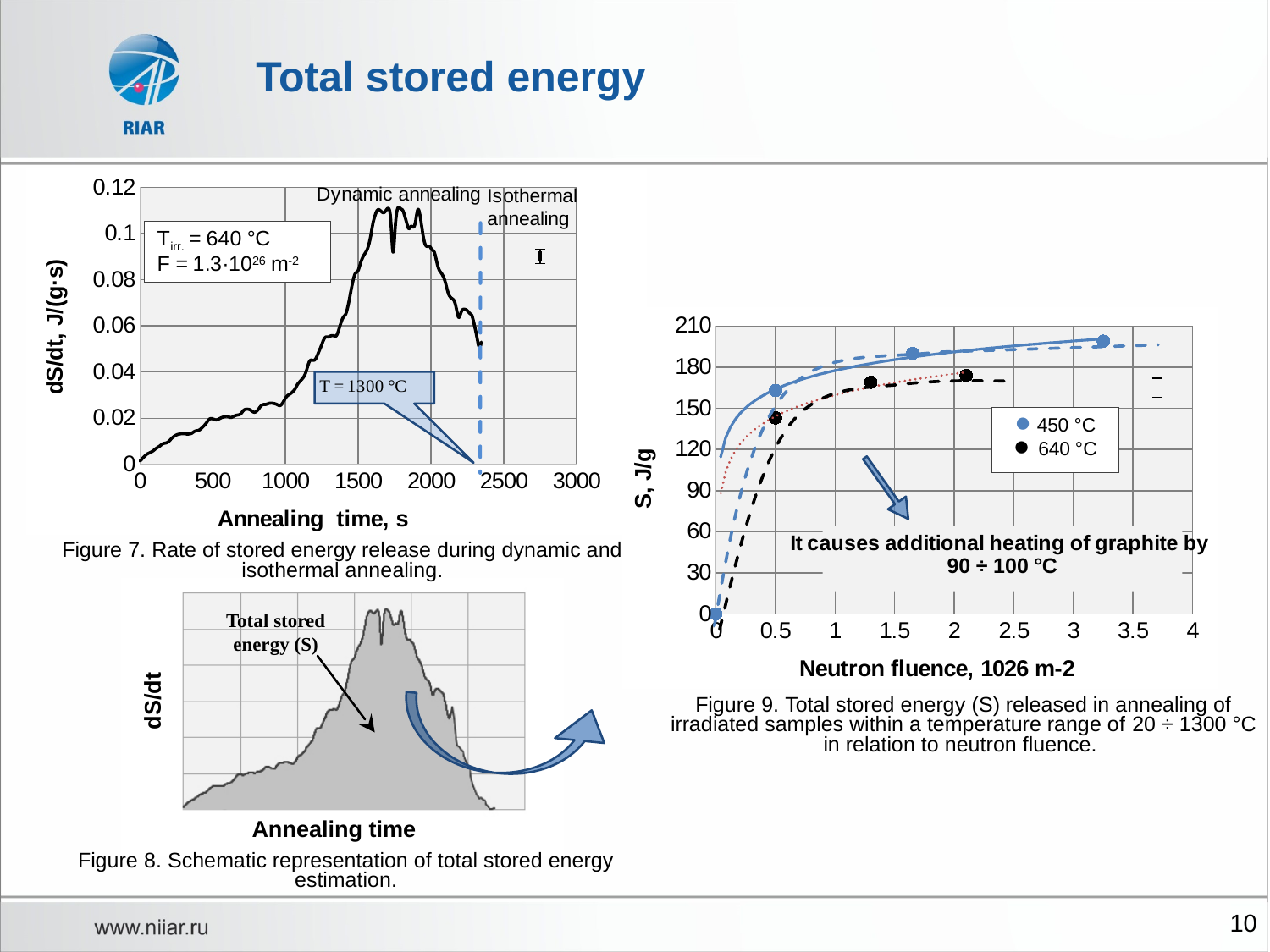
In Figure 7, is the peak value of dS/dt greater or less than 0.1 J/(g·s)? greater In Figure 9, is the value of S for the 640 °C series at a neutron fluence of 0.5 greater or less than 150 J/g? less In Figure 9, at a neutron fluence of 0.5, which series has the higher S value, 450 °C or 640 °C? 450 °C What kind of chart is Figure 7? line chart In Figure 9, what is the highest tick value shown on the S axis? 210 In Figure 9, does the total stored energy S rise or fall as neutron fluence increases? rise In Figure 9, is the value of S for the 450 °C series at a neutron fluence of about 3.25 greater or less than 180 J/g? greater In Figure 7, what is the title of the x axis? Annealing time, s In Figure 9, how many series does the legend list? 2 In Figure 7, what irradiation temperature T irr. is stated in the text box on the chart? 640 °C In Figure 9, what are the two series named in the legend? 450 °C and 640 °C